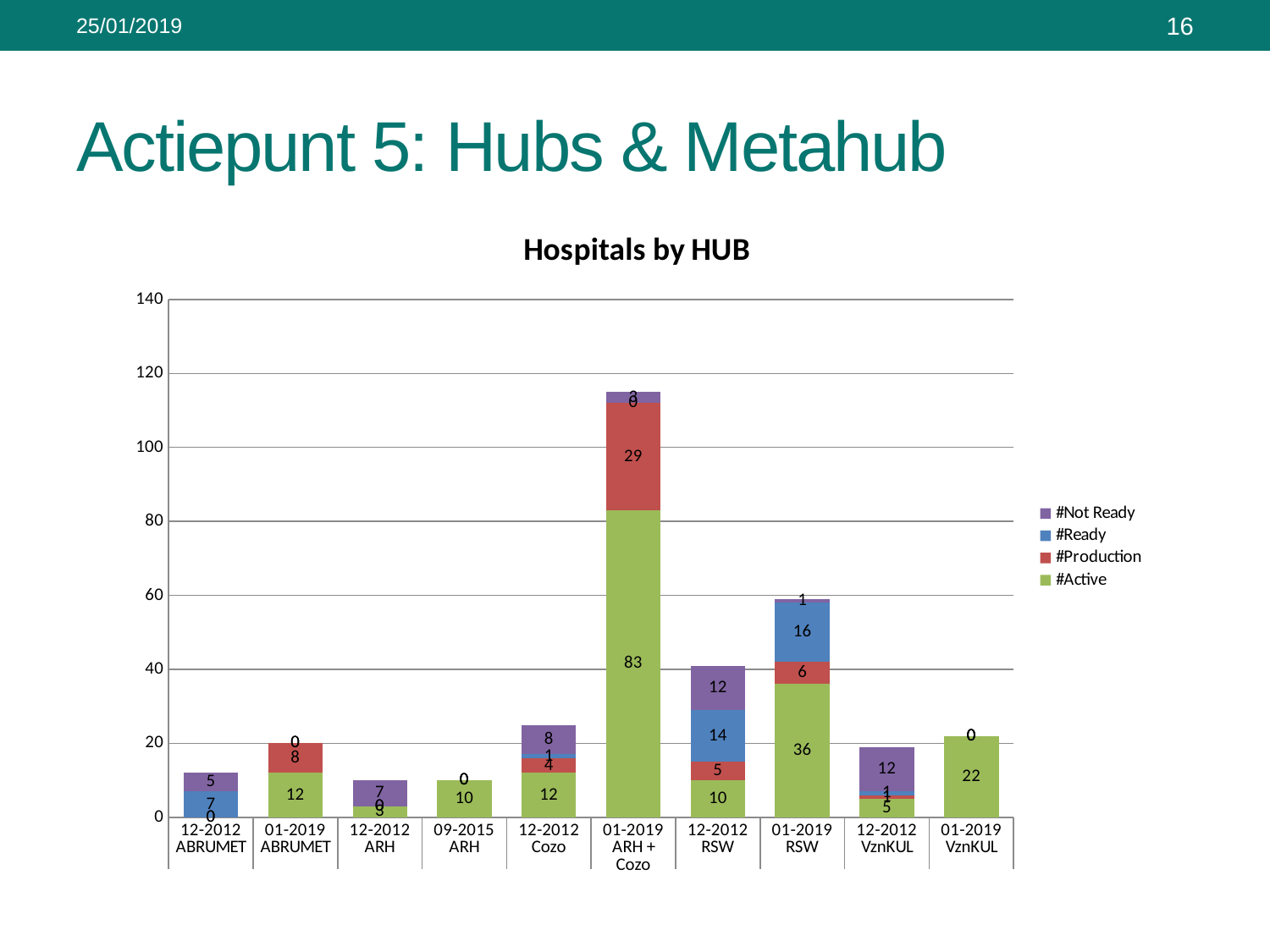
What kind of chart is shown on the slide? Stacked bar chart Is the total of the stacked bar for 01-2019 ARH + Cozo greater or less than 100? greater What is the #Active value for 01-2019 ARH + Cozo? 83 How many series does the legend of the 'Hospitals by HUB' chart list? 4 What is the total of the stacked bar for 01-2019 RSW? 59 What is the difference between the #Active value for 01-2019 RSW and the #Active value for 12-2012 RSW? 26 What is the #Active value for 01-2019 VznKUL? 22 Which is larger: the #Ready value for 12-2012 RSW or the #Ready value for 01-2019 RSW? 01-2019 RSW What is the #Production value for 01-2019 ARH + Cozo? 29 What is the #Ready value for 01-2019 RSW? 16 How many categories are shown along the x axis of the 'Hospitals by HUB' chart? 10 Which category has the tallest stacked bar? 01-2019 ARH + Cozo